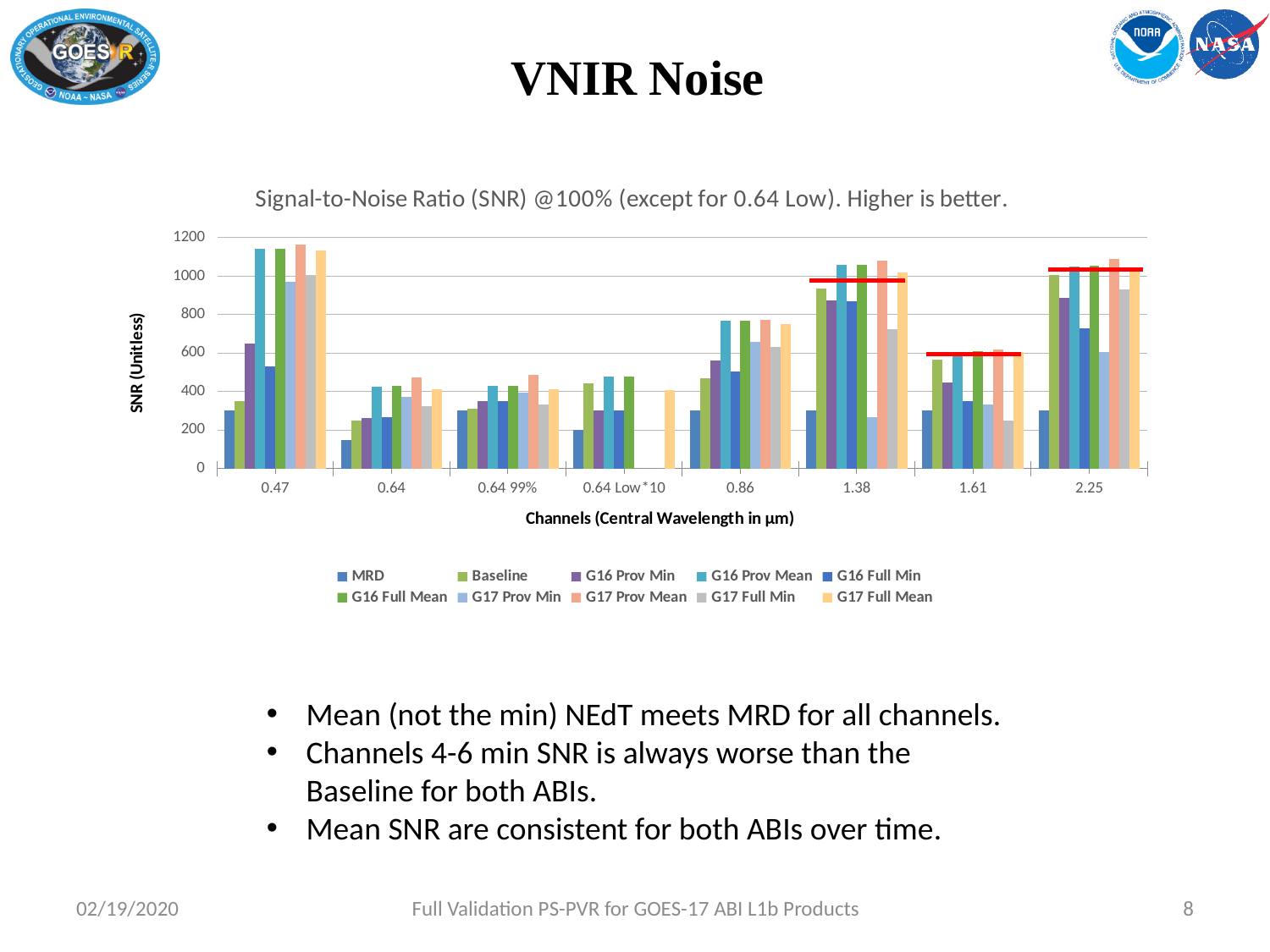
Is the MRD value for the 0.47 channel greater or less than 400? less Is the G17 Full Min value for the 1.61 channel greater or less than 400? less How many series does the chart's legend list? 10 Is the MRD value for the 0.64 channel greater or less than 200? less For the 0.47 channel, which is larger: the G16 Prov Mean value or the MRD value? G16 Prov Mean What is the title of the chart? Signal-to-Noise Ratio (SNR) @100% (except for 0.64 Low). Higher is better. What kind of chart is shown on the slide? Bar chart Which channel has the lowest MRD value? 0.64 How many channel categories are shown on the x axis of the chart? 8 What is the label of the chart's y axis? SNR (Unitless)